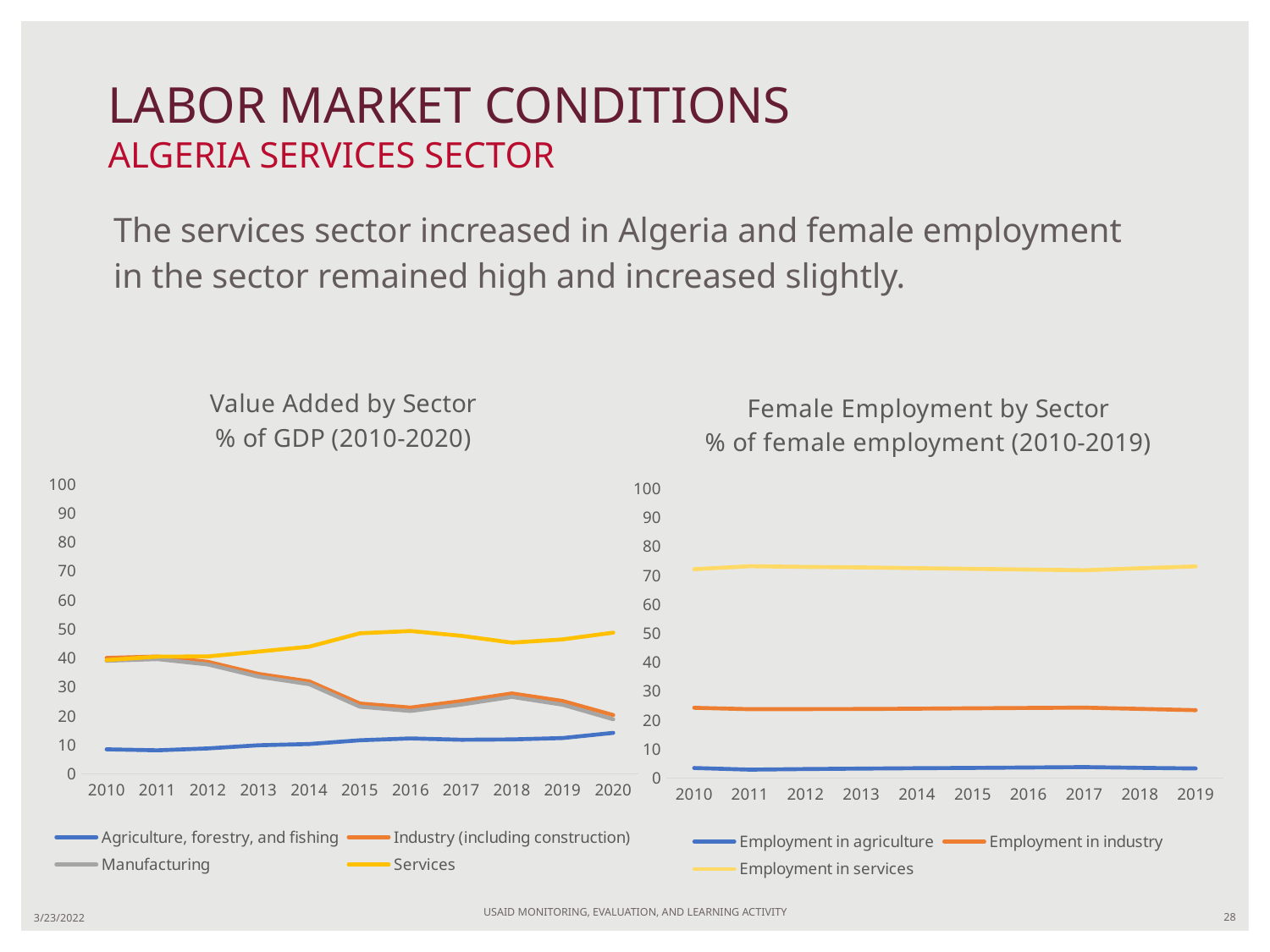
How many years are shown on the x axis of the 'Value Added by Sector' chart? 11 In the 'Value Added by Sector' chart, which series has the lowest value in 2010? Agriculture, forestry, and fishing In the 'Value Added by Sector' chart, does the Industry (including construction) line rise or fall from 2010 to 2020? fall How many series does the legend of the 'Female Employment by Sector' chart list? 3 In the 'Value Added by Sector' chart, is the value for Industry (including construction) in 2020 greater or less than 30? less How many series does the legend of the 'Value Added by Sector' chart list? 4 How many years are shown on the x axis of the 'Female Employment by Sector' chart? 10 In the 'Female Employment by Sector' chart, is the value for Employment in services in 2019 greater or less than 70? greater In the 'Value Added by Sector' chart, is the value for Services in 2020 greater or less than 40? greater What kind of chart is the 'Value Added by Sector' chart on the left? line chart In the 'Female Employment by Sector' chart, which series has the highest values across all years? Employment in services